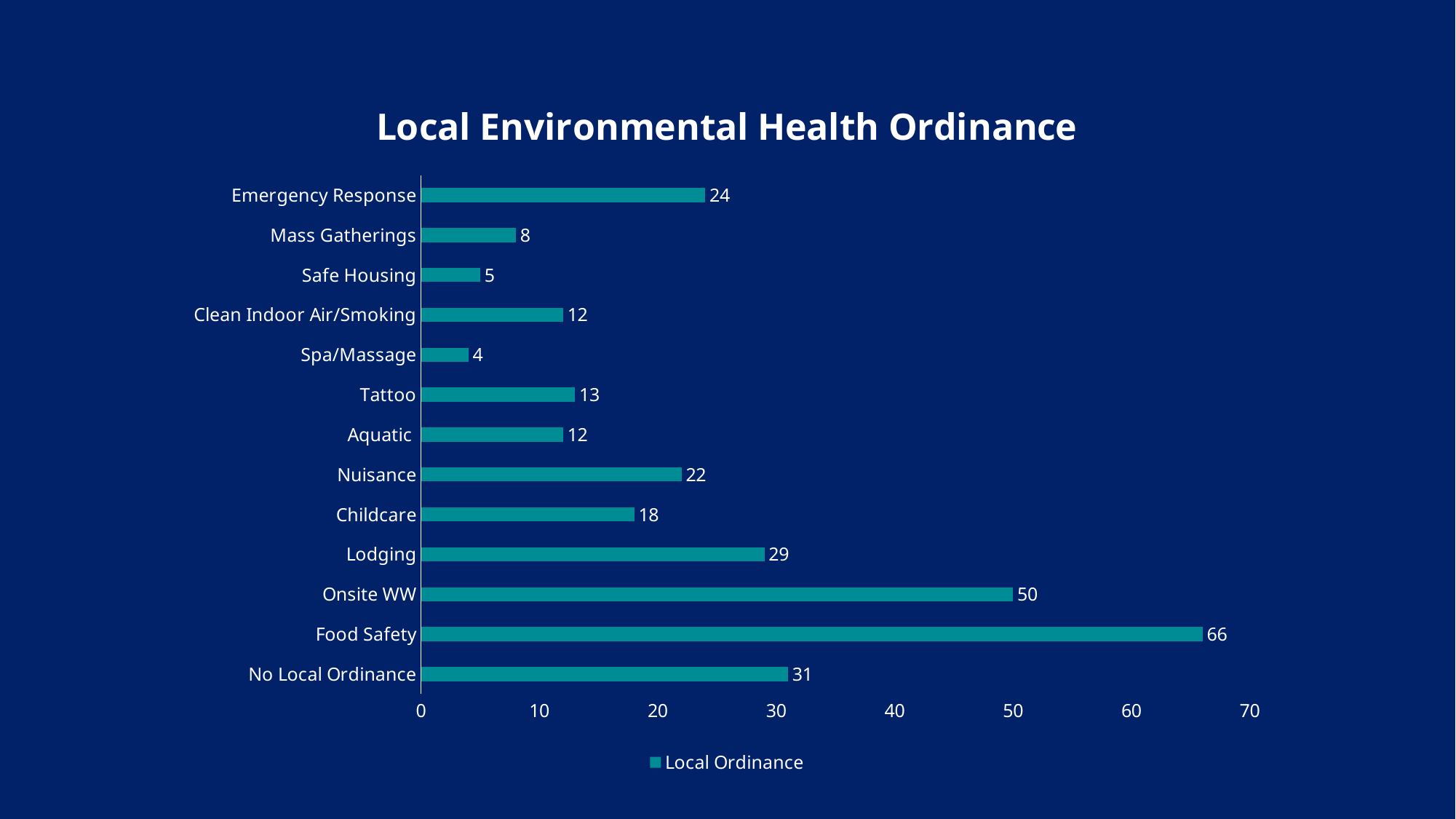
Which category has the lowest value? Spa/Massage Which is larger, the value for Lodging or the value for Emergency Response? Lodging Is the value for Nuisance greater or less than 20? greater What is the value for Spa/Massage? 4 How many categories are shown in the chart? 13 What is the title of the chart? Local Environmental Health Ordinance What is the value for Onsite WW? 50 What is the value for No Local Ordinance? 31 Which category has the highest value? Food Safety What is the difference between the values for Food Safety and Onsite WW? 16 What is the value for Food Safety? 66 What kind of chart is this? Bar chart